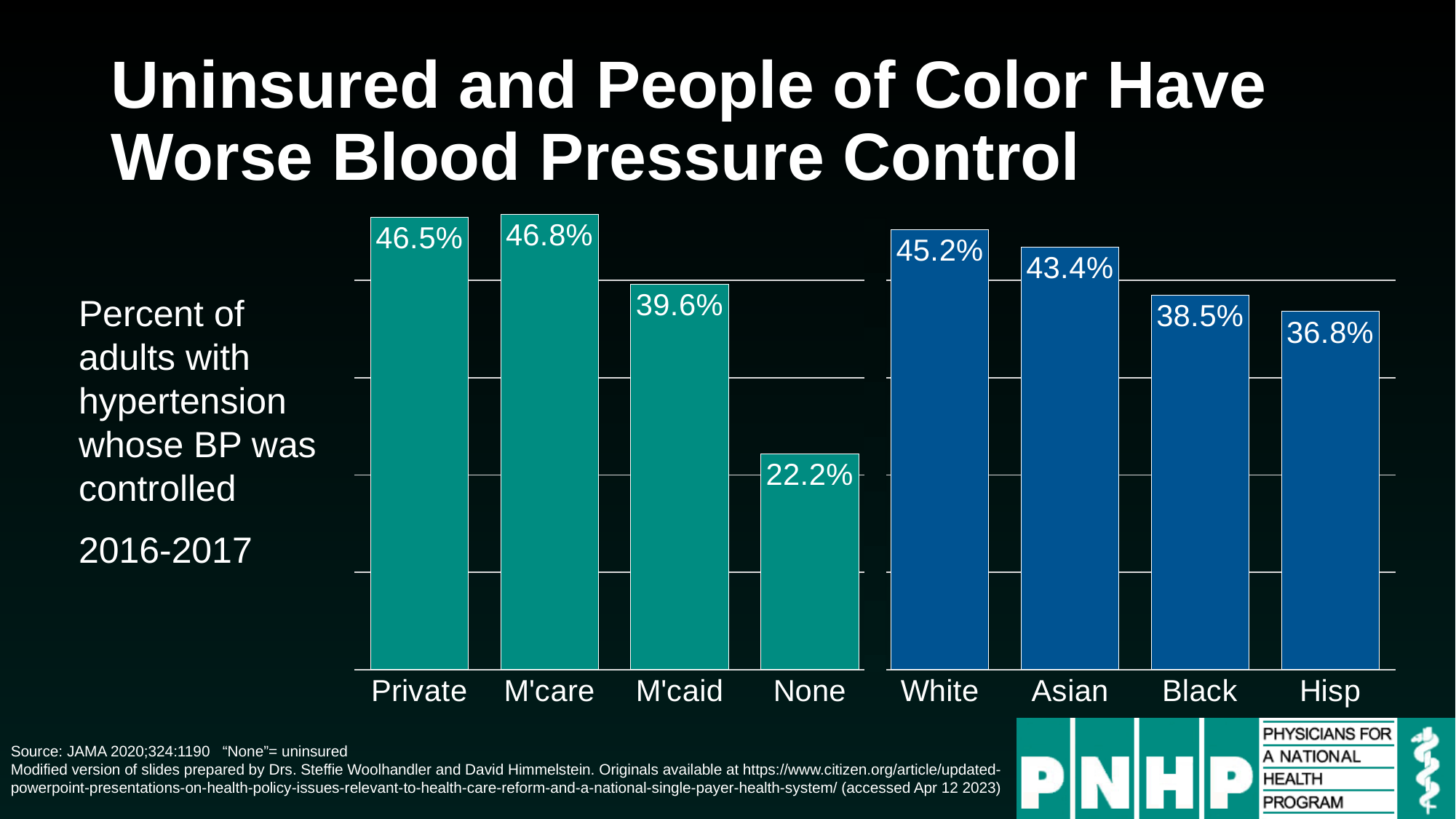
Do the values rise or fall moving from White to Asian to Black to Hisp? Fall Which category has the lowest percentage of controlled blood pressure? None What is the value shown for the Black group? 38.5% What is the difference in percentage points between the Private and None groups? 24.3 Which group has a higher value, M'caid or Black? M'caid What is the difference in percentage points between the White and Hisp groups? 8.4 What is the value shown for the Asian group? 43.4% What percent of adults with hypertension had their BP controlled among those with private insurance? 46.5% How many categories are shown on the x axis of the chart? 8 What is the value shown for the None (uninsured) group? 22.2% Which category has the highest percentage of controlled blood pressure? M'care What kind of chart is shown on the slide? Bar chart